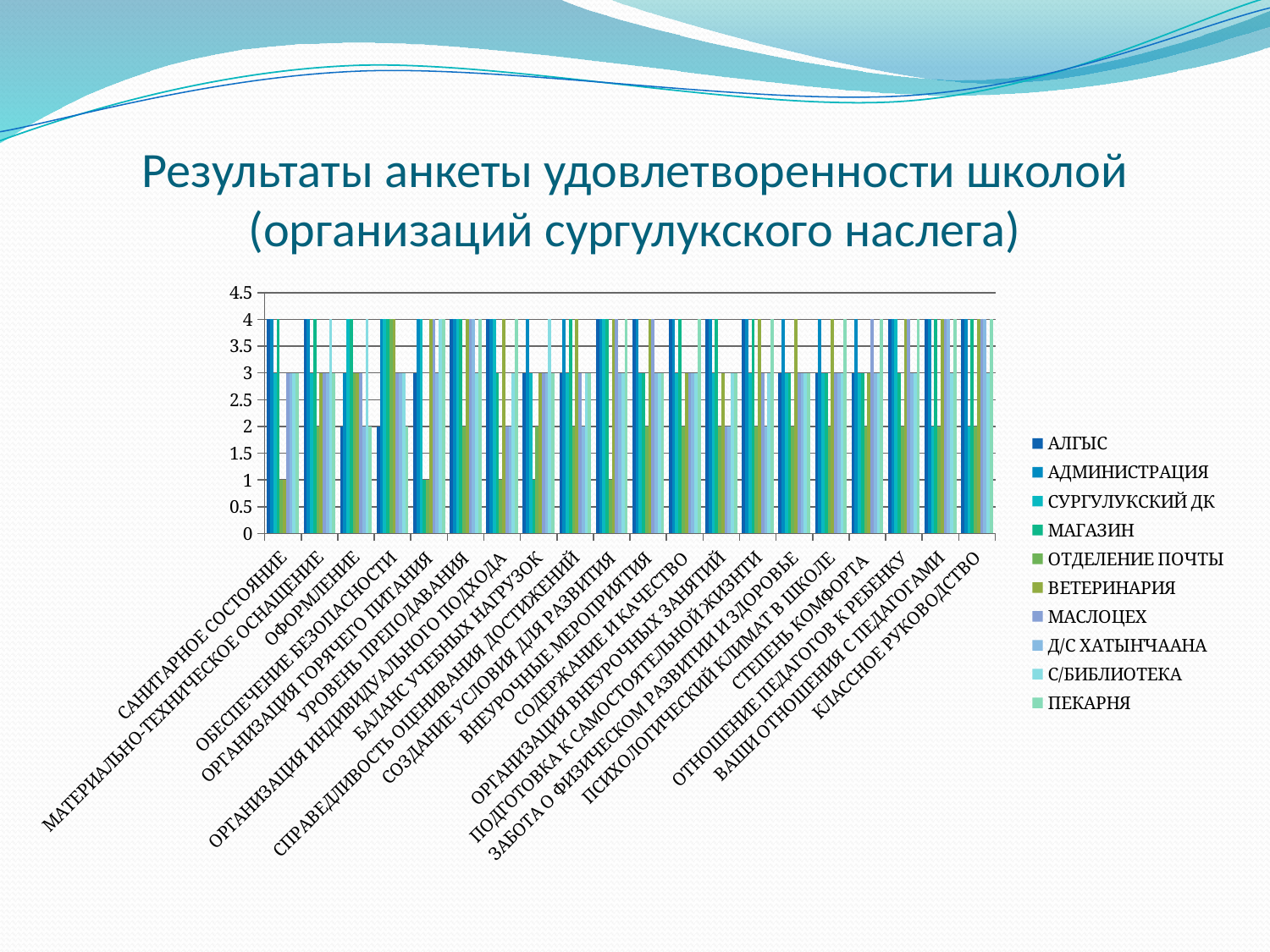
What kind of chart is shown on the slide? bar chart How many categories are shown along the x axis of the chart? 20 How many series does the chart legend list? 10 Is the value for АЛГЫС in the category КЛАССНОЕ РУКОВОДСТВО greater or less than 3? greater What is the value for АЛГЫС in the category УРОВЕНЬ ПРЕПОДАВАНИЯ? 4 Which is larger in the category САНИТАРНОЕ СОСТОЯНИЕ: the value for АЛГЫС or the value for ОТДЕЛЕНИЕ ПОЧТЫ? АЛГЫС What is the value for АЛГЫС in the category САНИТАРНОЕ СОСТОЯНИЕ? 4 Which series is listed first in the chart legend? АЛГЫС Is the value for ОТДЕЛЕНИЕ ПОЧТЫ in the category САНИТАРНОЕ СОСТОЯНИЕ greater or less than 2? less What is the title of the slide containing the chart? Результаты анкеты удовлетворенности школой (организаций сургулукского наслега)